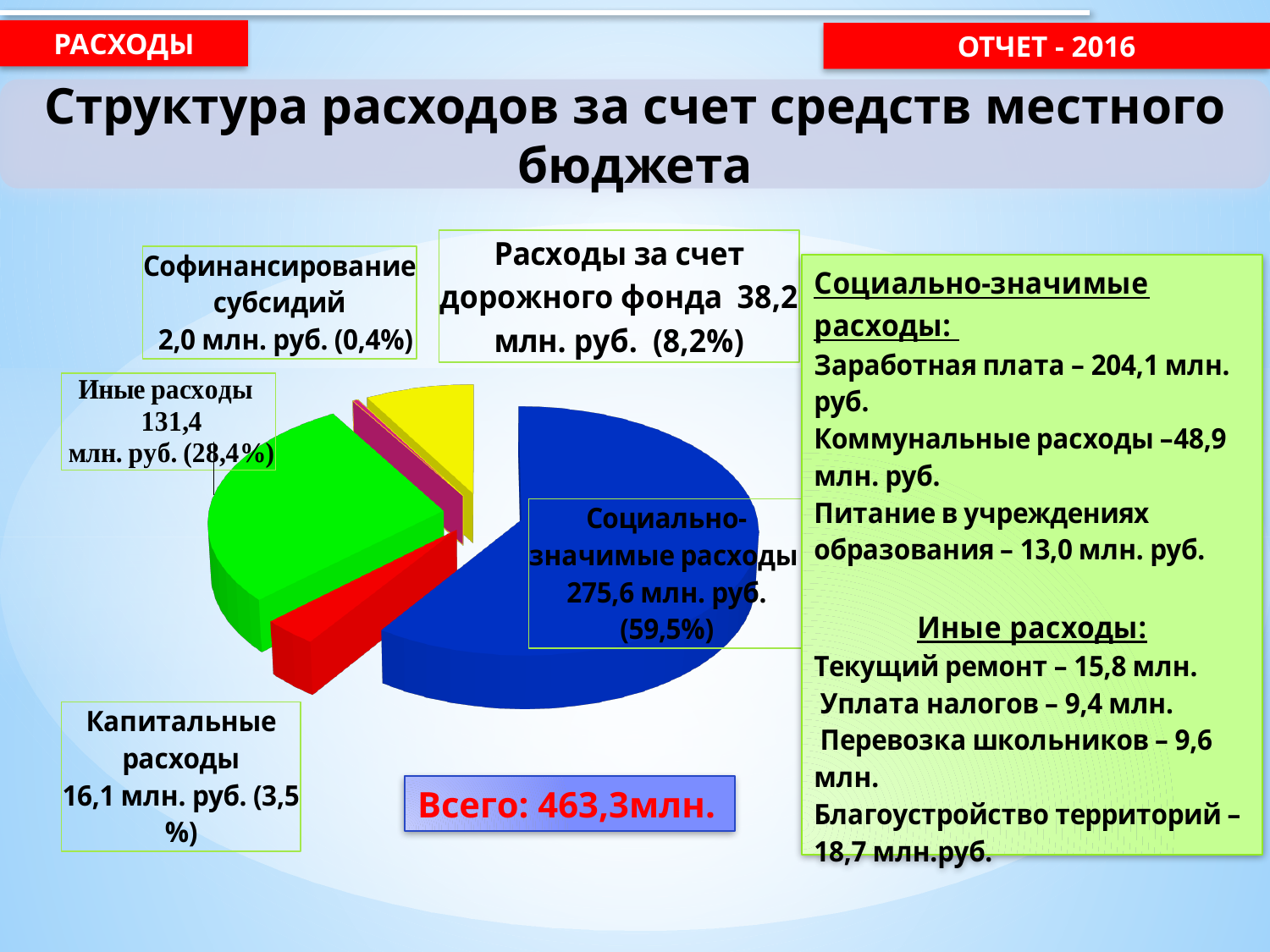
What is the value for Расходы за счет дорожного фонда? 38,2 млн. руб. What is the value for Социально-значимые расходы? 275,6 млн. руб. What kind of chart is shown on the slide? pie chart What is the difference in млн. руб. between Социально-значимые расходы and Иные расходы? 144,2 млн. руб. Which is larger: Иные расходы or Капитальные расходы? Иные расходы What is the value for Софинансирование субсидий? 2,0 млн. руб. What total is shown for all expenses on the slide? 463,3 млн. Which category has the largest slice of the pie? Социально-значимые расходы How many slices does the pie chart have? 5 What share of the pie do Иные расходы make up? 28,4% Which category has the smallest slice of the pie? Софинансирование субсидий What share of the pie do Капитальные расходы make up? 3,5%